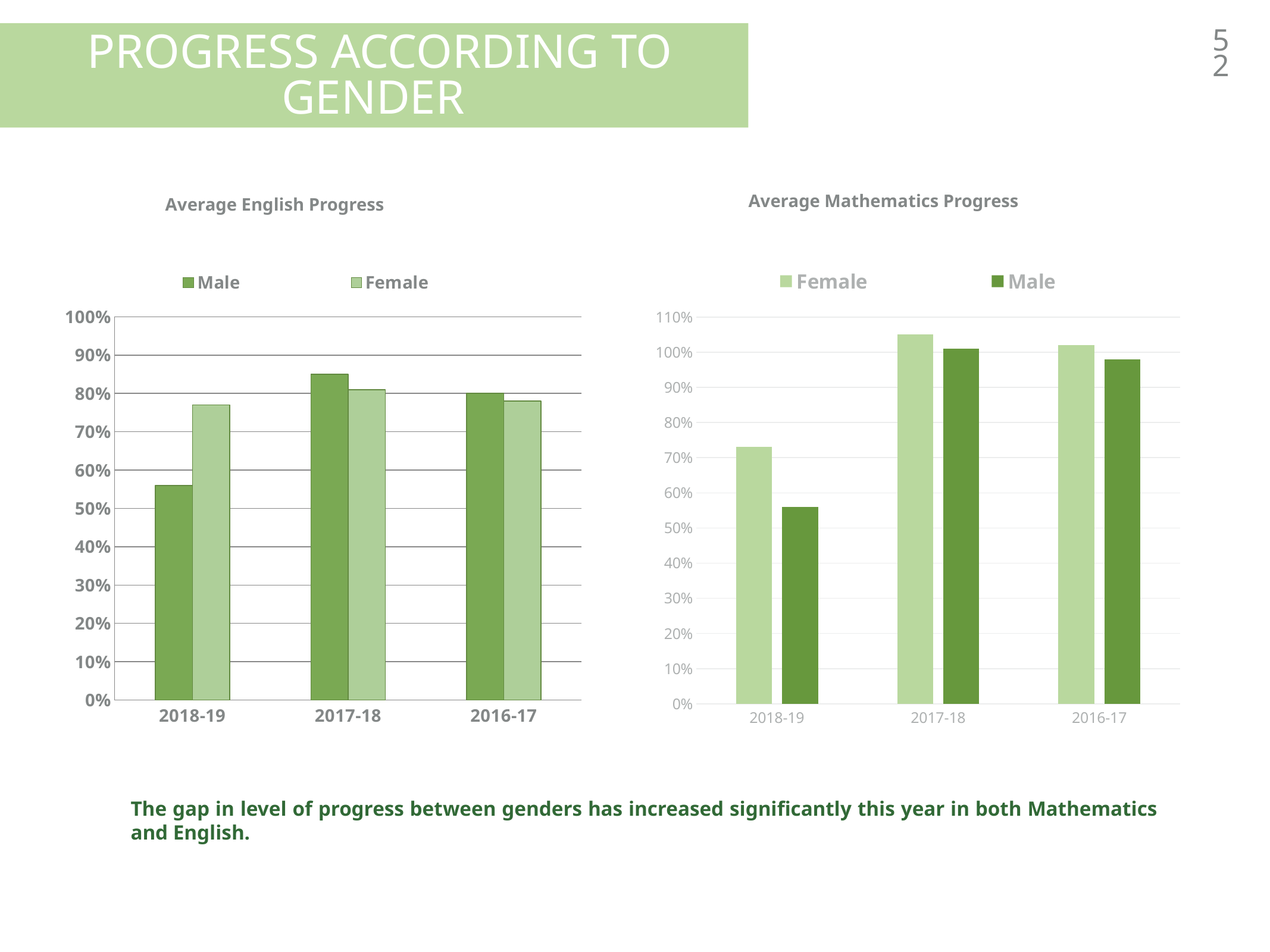
In the Average Mathematics Progress chart, is the Male value for 2018-19 greater or less than 60%? less What is the title of the chart on the right side of the slide? Average Mathematics Progress In the Average Mathematics Progress chart, is the Female value for 2017-18 greater or less than 100%? greater In the Average Mathematics Progress chart, which is larger for 2016-17, Female or Male? Female In the Average English Progress chart, is the Male value for 2018-19 greater or less than 60%? less In the Average Mathematics Progress chart, which year has the lowest Female value? 2018-19 In the Average English Progress chart, which is larger for 2018-19, Male or Female? Female In the Average English Progress chart, which year has the lowest Male value? 2018-19 What kind of chart is the Average English Progress chart? bar chart How many year categories are shown on the x axis of the Average English Progress chart? 3 How many series does the legend of the Average Mathematics Progress chart list? 2